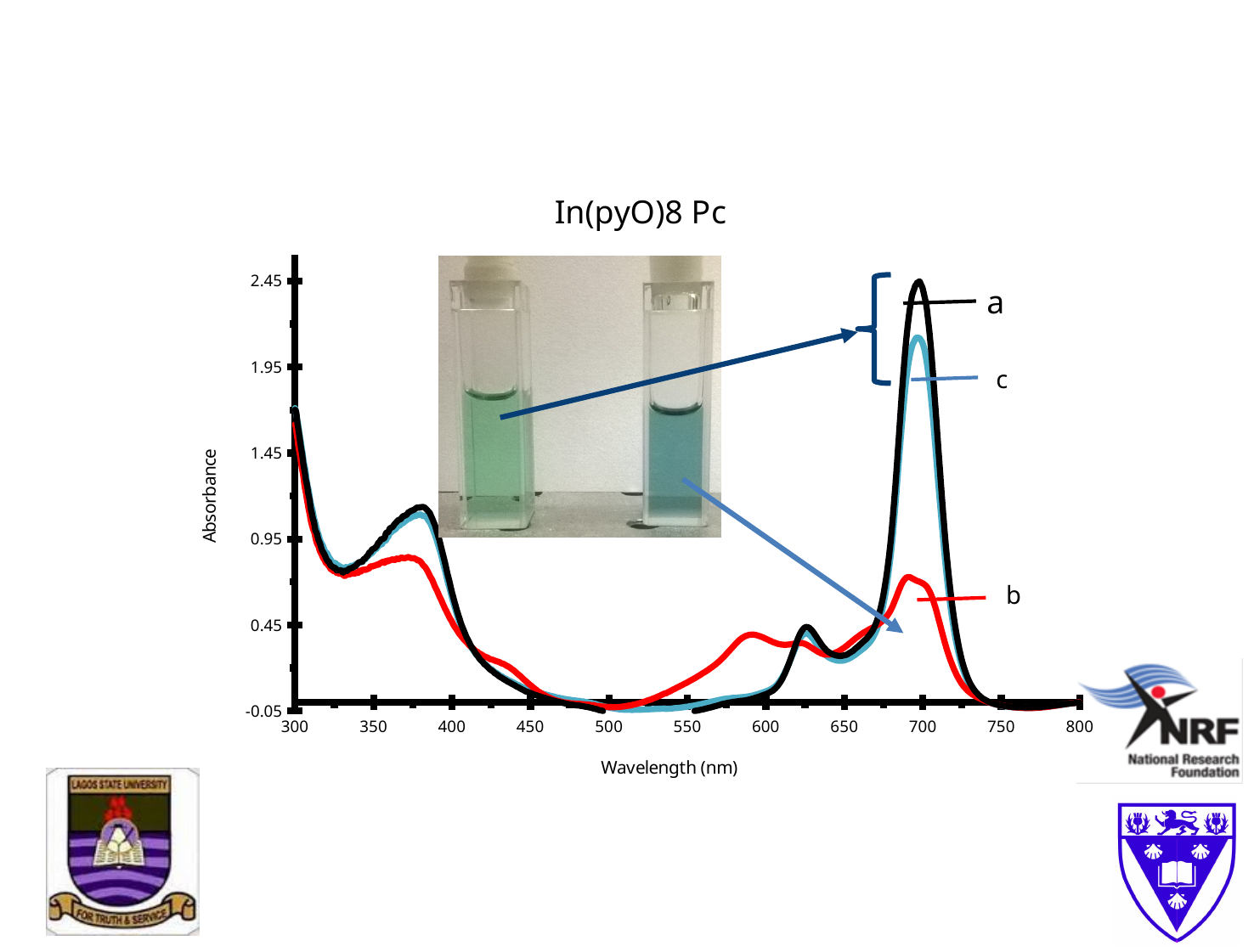
How many curves (a, b, c) are plotted on the chart? 3 Is the peak absorbance of curve a near 700 nm greater or less than 1.95? greater Is the peak absorbance of curve c near 700 nm greater or less than 1.45? greater What is the title of the chart? In(pyO)8 Pc What kind of chart is shown on the slide? line chart Is the absorbance of curve a at about 380 nm greater or less than 0.95? greater At about 700 nm, which curve has the larger absorbance, a or b? a Between 700 nm and 750 nm, does the absorbance of curve a rise or fall? fall Which curve has the lowest peak absorbance near 700 nm? b What colour is curve b drawn in? red Which curve reaches the highest absorbance near 700 nm? a